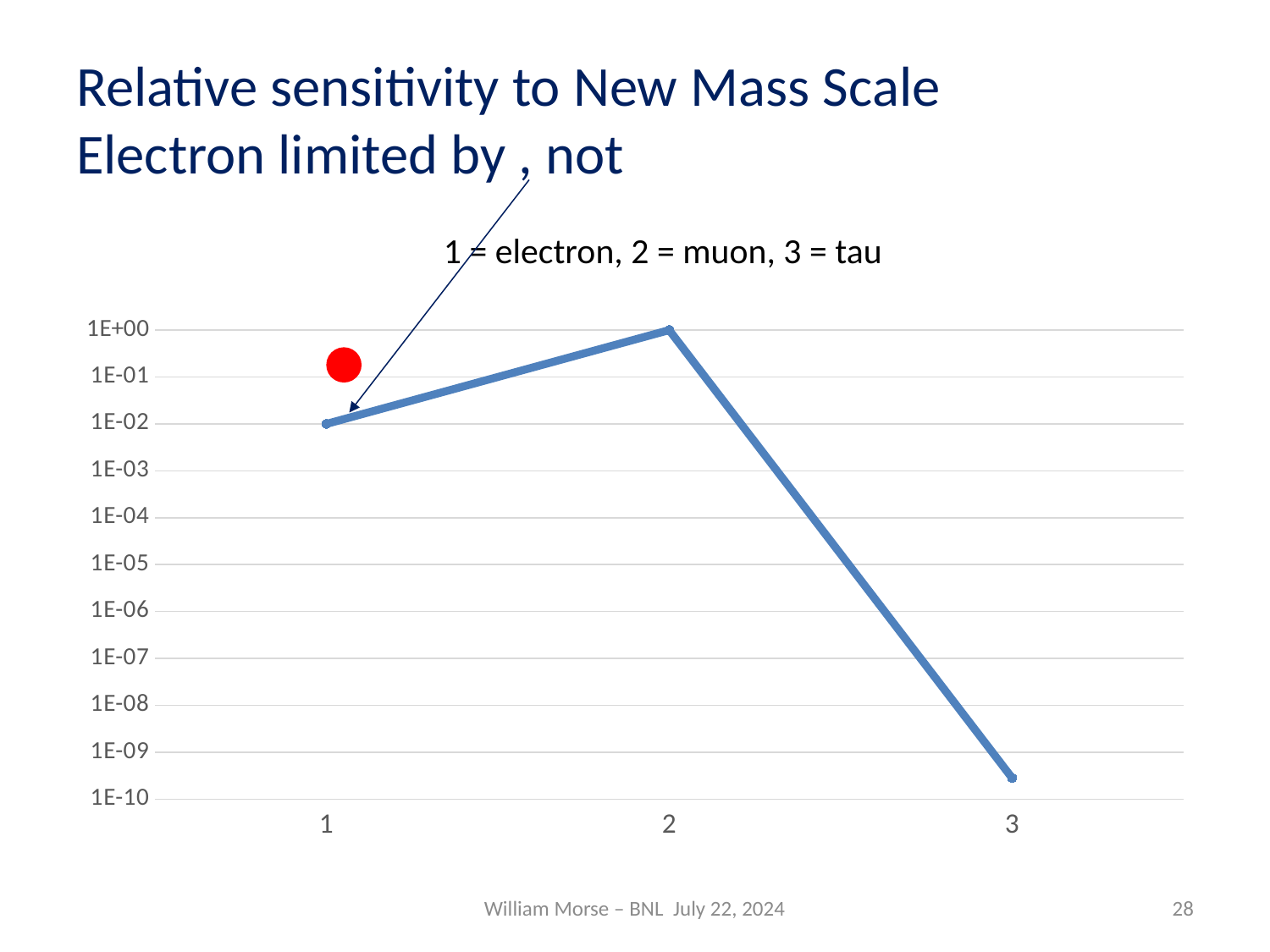
Does the line rise or fall from x = 2 to x = 3? fall What is the plotted value at x = 2 (muon)? 1E+00 How many data points are plotted on the line? 3 Which x category has the lowest plotted value? 3 Which x category has the highest plotted value? 2 Is the plotted value at x = 3 (tau) greater or less than 1E-09? less What kind of chart is shown on the slide? line chart What colour is the plotted line? blue What is the plotted value at x = 1 (electron)? 1E-02 What is the title text shown above the chart? 1 = electron, 2 = muon, 3 = tau Which has the larger plotted value, x = 1 or x = 3? 1 Is the plotted value at x = 3 (tau) greater or less than 1E-10? greater